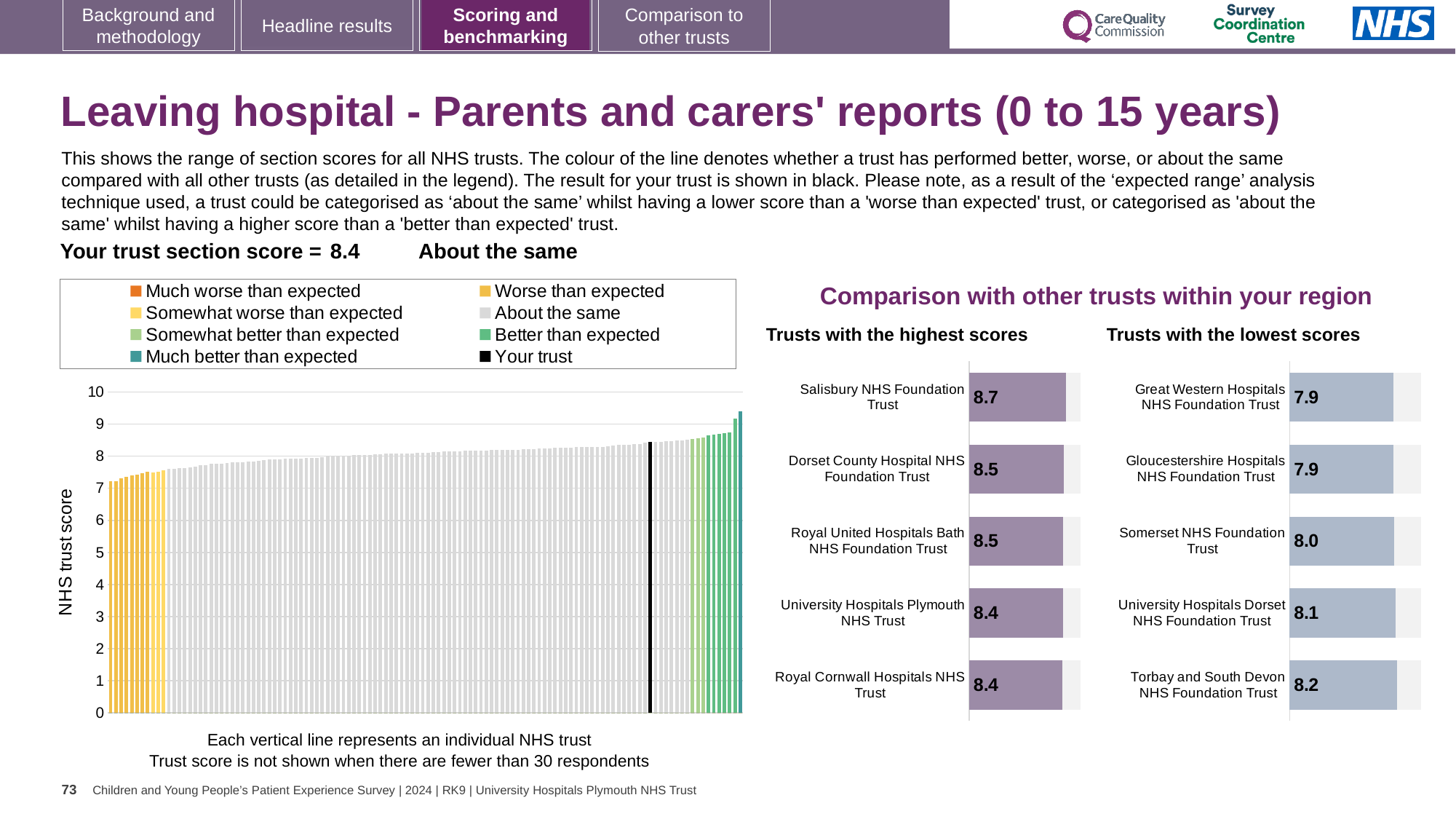
In the main 'NHS trust score' chart on the left, do the values rise or fall from left to right? rise In the 'Trusts with the lowest scores' chart, which has the larger score: Torbay and South Devon NHS Foundation Trust or Great Western Hospitals NHS Foundation Trust? Torbay and South Devon NHS Foundation Trust In the main 'NHS trust score' chart on the left, what is the section score for your trust? 8.4 In the 'Trusts with the highest scores' chart, how many trusts are listed? 5 In the 'Trusts with the highest scores' chart, what is the difference between the scores of Salisbury NHS Foundation Trust and Royal Cornwall Hospitals NHS Trust? 0.3 In the 'Trusts with the highest scores' chart, what is the score for Salisbury NHS Foundation Trust? 8.7 In the 'Trusts with the lowest scores' chart, what is the score for Somerset NHS Foundation Trust? 8.0 In the 'Trusts with the lowest scores' chart, which trust has the highest score? Torbay and South Devon NHS Foundation Trust In the main 'NHS trust score' chart on the left, is the value of the leftmost bar greater or less than 8? less How many entries does the legend of the main 'NHS trust score' chart list? 8 In the 'Trusts with the highest scores' chart, which trust has the highest score? Salisbury NHS Foundation Trust What kind of chart is the 'Trusts with the lowest scores' chart? bar chart